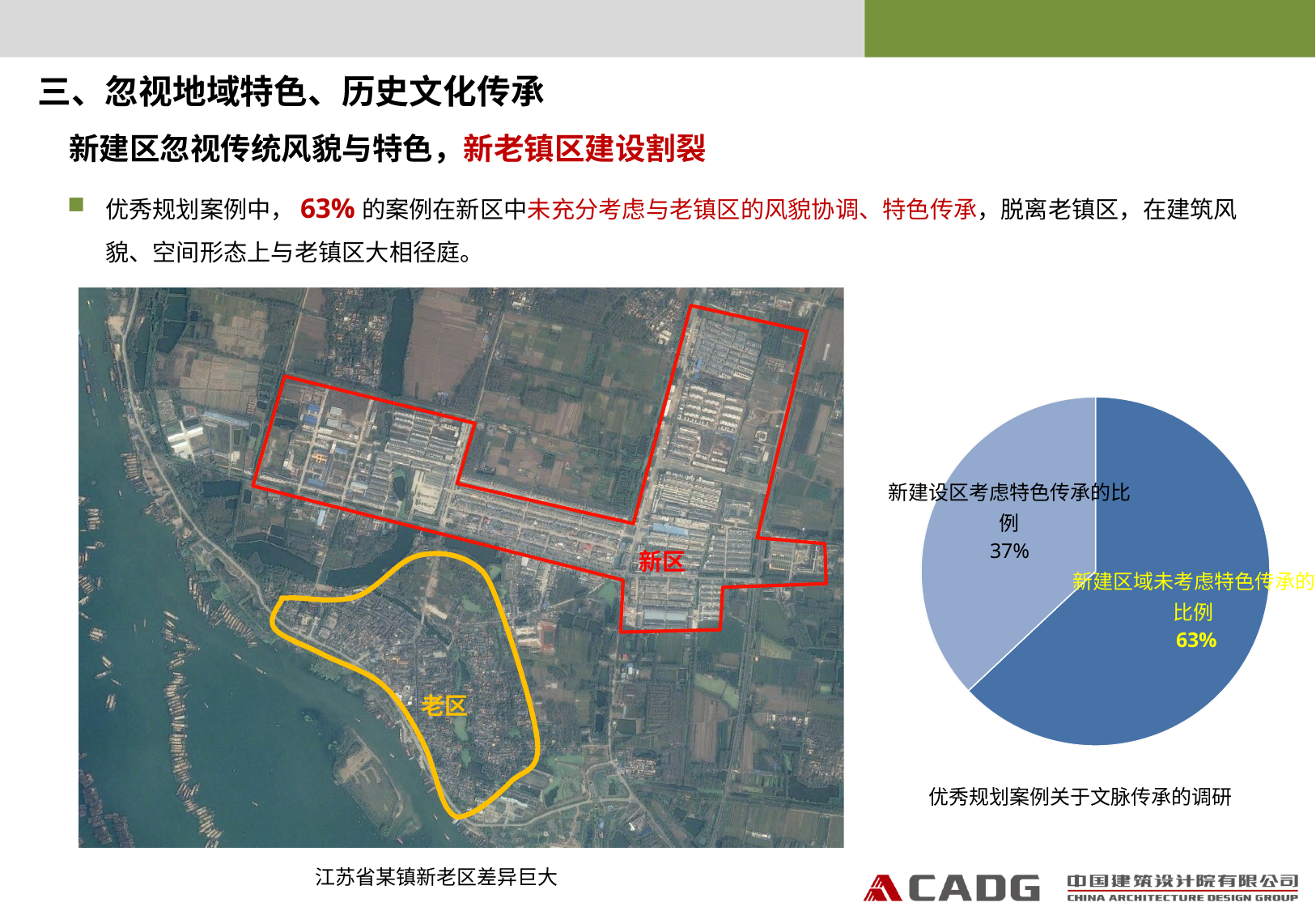
What share of the pie does the 新建区域未考虑特色传承的比例 slice represent? 63% In the pie chart, what colour is the 63% slice? dark blue What is the caption printed below the pie chart? 优秀规划案例关于文脉传承的调研 What kind of chart is shown on the right side of the slide? pie chart Which slice of the pie chart is the smallest? 新建设区考虑特色传承的比例 What is the difference in percentage points between the two slices of the pie chart? 26 In the pie chart, what is the value for 新建区域未考虑特色传承的比例? 63% Which is larger in the pie chart: 新建设区考虑特色传承的比例 or 新建区域未考虑特色传承的比例? 新建区域未考虑特色传承的比例 Which slice of the pie chart is the largest? 新建区域未考虑特色传承的比例 In the pie chart, what is the value for 新建设区考虑特色传承的比例? 37% How many slices does the pie chart have? 2